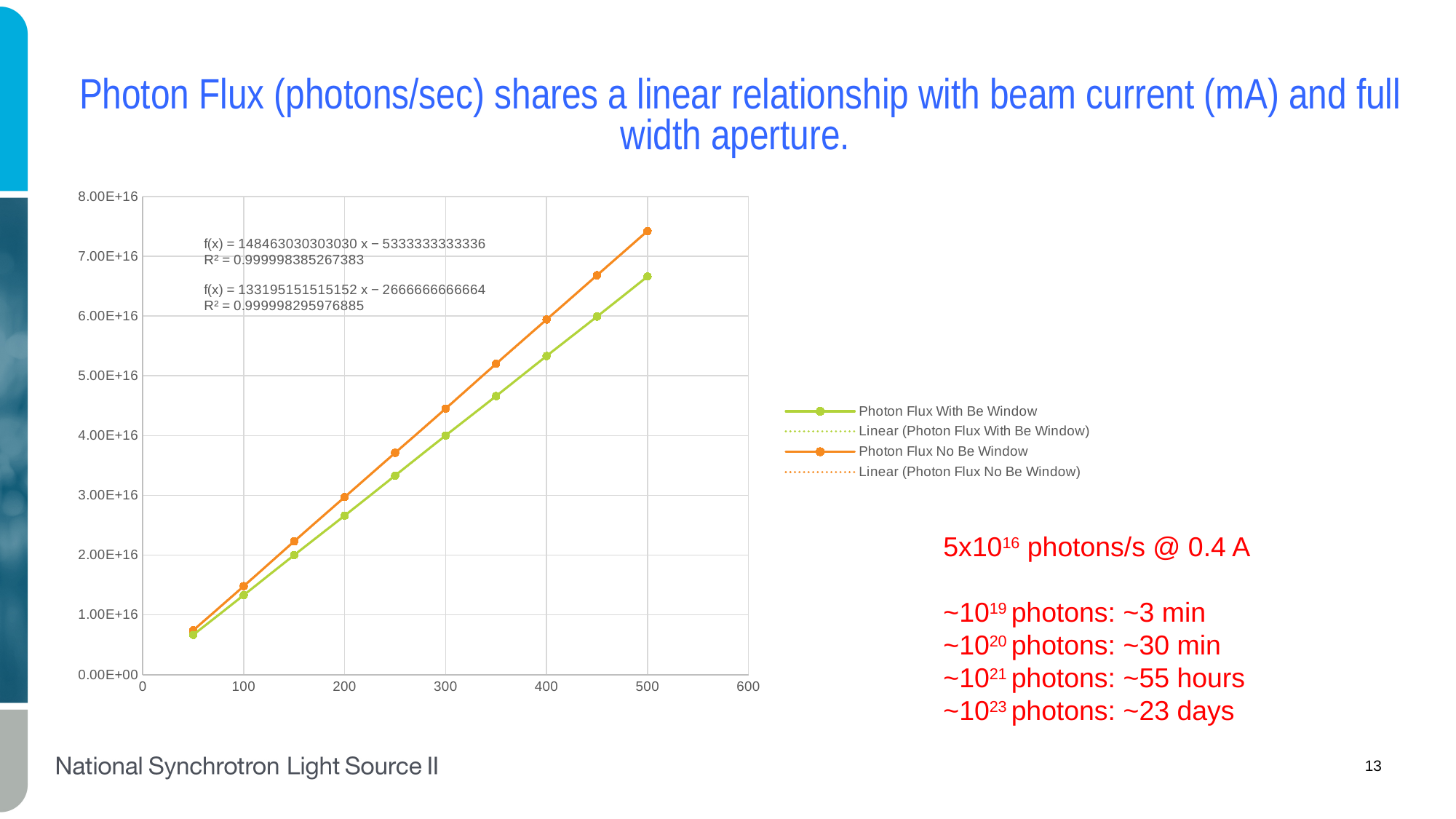
Is the value for Photon Flux No Be Window at 500 greater or less than 7.00E+16? greater Do the Photon Flux With Be Window values rise or fall as beam current increases along the x axis? rise Is the value for Photon Flux With Be Window at 500 greater or less than 7.00E+16? less Is the value for Photon Flux With Be Window at 100 greater or less than 2.00E+16? less What colour is the line for Photon Flux No Be Window? orange Which series reaches the highest value on the chart? Photon Flux No Be Window What is the R² value printed for the first trendline equation on the chart? 0.999998385267383 At a beam current of 500, which series has the larger value: Photon Flux With Be Window or Photon Flux No Be Window? Photon Flux No Be Window How many entries does the chart legend list? 4 What kind of chart is shown on the slide? line chart How many data points are plotted for the Photon Flux No Be Window series? 10